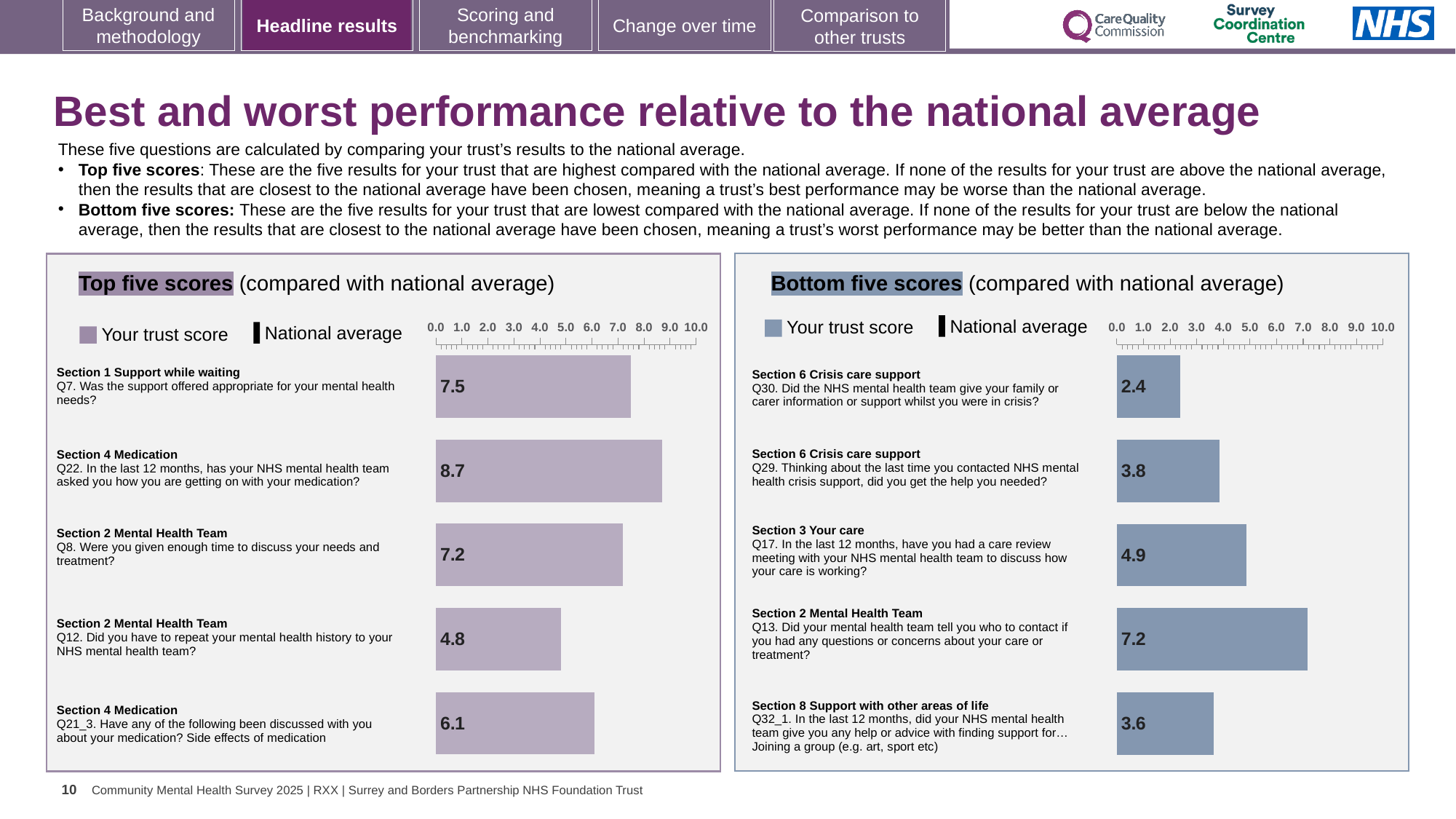
In the Top five scores chart, what is the difference between the trust scores for Q22 and Q12? 3.9 In the Bottom five scores chart, what is the difference between the trust scores for Q13 and Q30? 4.8 In the Bottom five scores chart, which question has the lowest trust score? Q30 In the Top five scores chart, which question has the highest trust score? Q22 In the Top five scores chart, what is the trust score for Q22 (asked how you are getting on with your medication)? 8.7 In the Bottom five scores chart, what is the trust score for Q17 (care review meeting)? 4.9 In the Bottom five scores chart, which has the larger trust score, Q29 or Q32_1? Q29 What kind of chart is the Top five scores chart? Bar chart In the Bottom five scores chart, what is the trust score for Q30 (information or support for family or carer whilst in crisis)? 2.4 How many questions are plotted in the Bottom five scores chart? 5 How many entries does the legend of the Top five scores chart list? 2 In the Top five scores chart, what is the trust score for Q12 (repeat your mental health history)? 4.8